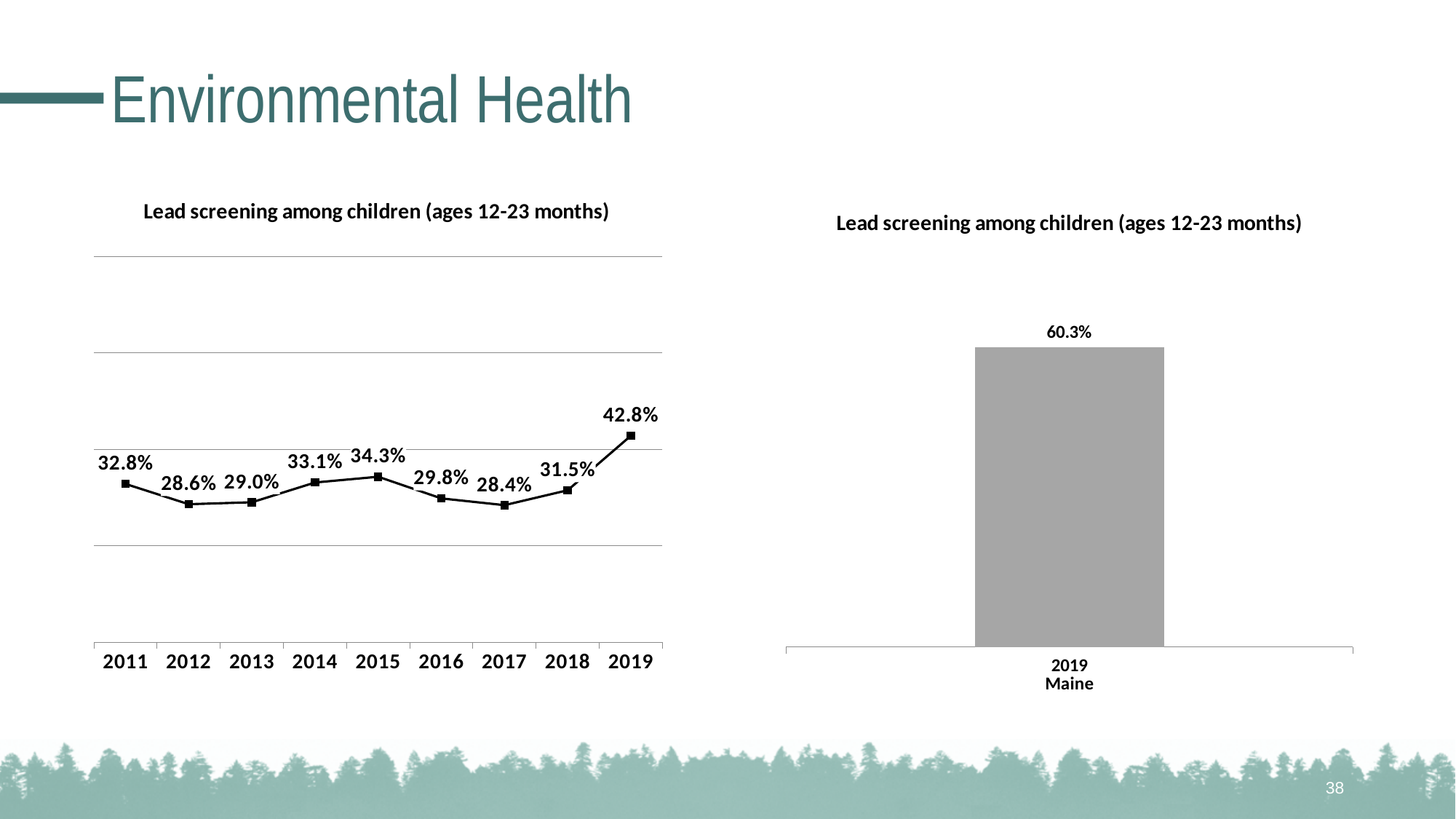
In the right chart, what is the lead screening value for Maine in 2019? 60.3% In the left line chart, what is the value for 2015? 34.3% In the left line chart, which year has the highest value? 2019 In the left line chart, which is larger, the value for 2014 or the value for 2016? 2014 In the left line chart, what is the lead screening value for 2011? 32.8% In the left line chart, what is the difference between the 2019 value and the 2018 value? 11.3% What is the title of the chart on the right? Lead screening among children (ages 12-23 months) What kind of chart is the chart on the left? line chart How many years are plotted in the left line chart? 9 What kind of chart is the chart on the right? bar chart In the left line chart, what is the lead screening value for 2019? 42.8% In the left line chart, which year has the lowest value? 2017